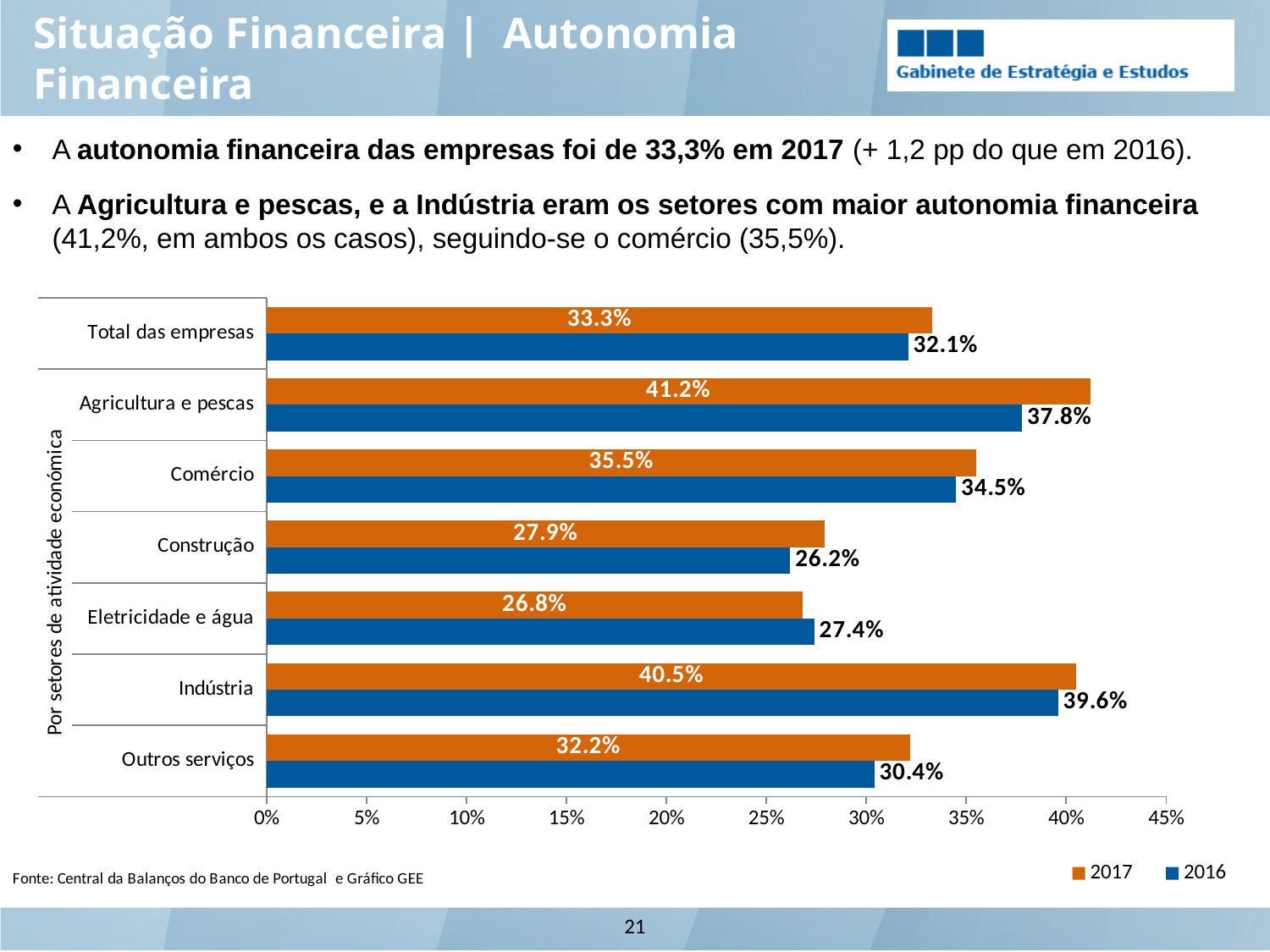
How many categories are shown on the chart? 7 Which category has the lowest value in the 2017 series? Eletricidade e água How many series does the legend list? 2 Which category has the lowest value in the 2016 series? Construção What was the financial autonomy value for Agricultura e pescas in 2017? 41.2% Which is larger for Eletricidade e água: the 2017 value or the 2016 value? 2016 What was the value for Total das empresas in 2016? 32.1% What is the difference between the 2017 and 2016 values for Construção? 1.7 percentage points What kind of chart is shown on the slide? Bar chart Is the 2016 value for Outros serviços greater or less than 35%? less What was the value for Indústria in 2016? 39.6% Which category has the highest value in the 2017 series? Agricultura e pescas